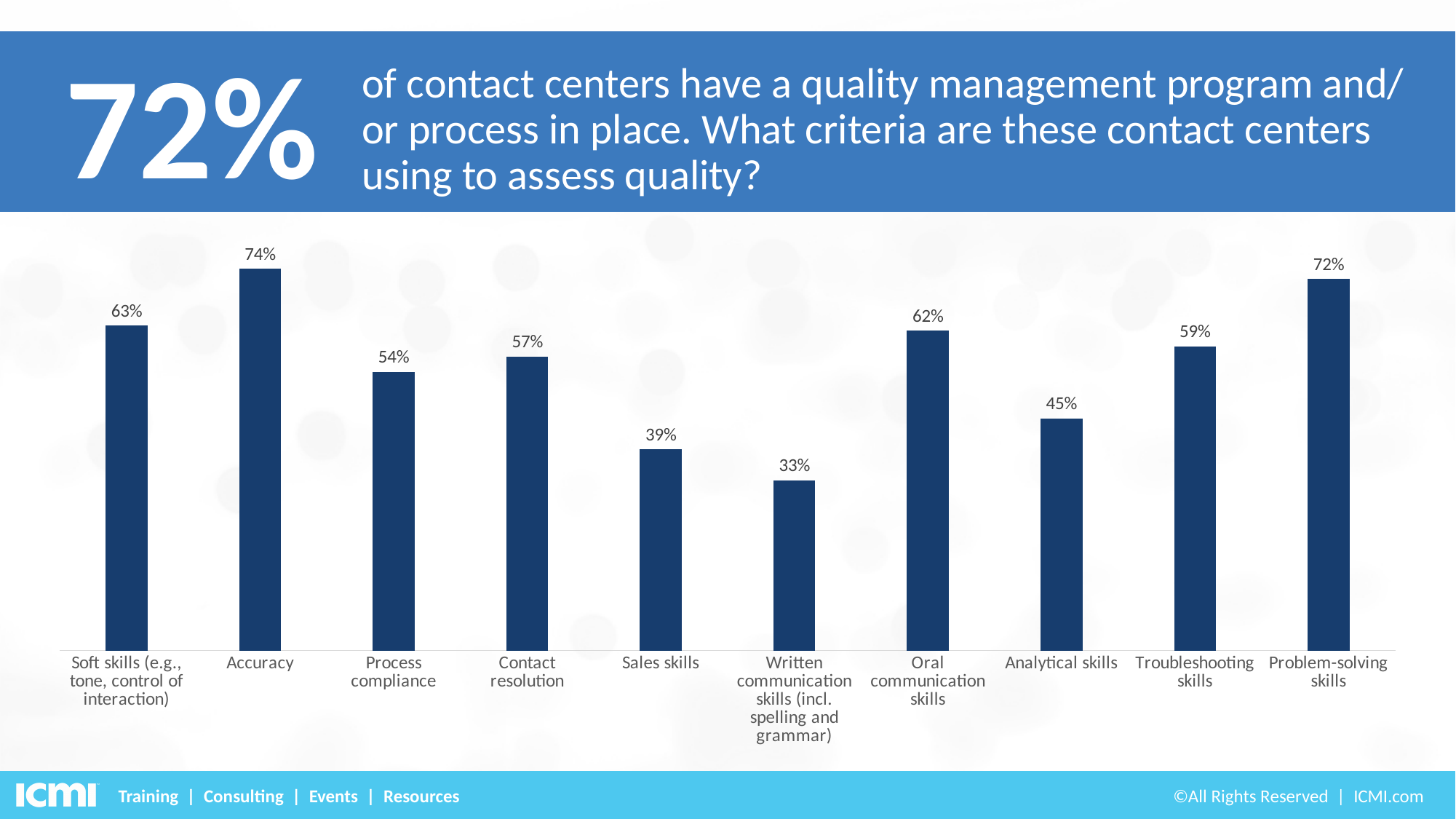
Which criterion has the lowest percentage? Written communication skills (incl. spelling and grammar) What kind of chart is shown on the slide? Bar chart What percentage of contact centers use Accuracy as a quality assessment criterion? 74% What is the difference between the values for Soft skills and Analytical skills? 18% What is the difference between the values for Accuracy and Problem-solving skills? 2% How many criteria are shown in the chart? 10 Which criterion has the highest percentage? Accuracy What is the value shown for Oral communication skills? 62% What is the value shown for Sales skills? 39% What large percentage figure is shown in the slide header? 72% Which is larger, the value for Contact resolution or the value for Process compliance? Contact resolution Which is larger, the value for Troubleshooting skills or the value for Oral communication skills? Oral communication skills